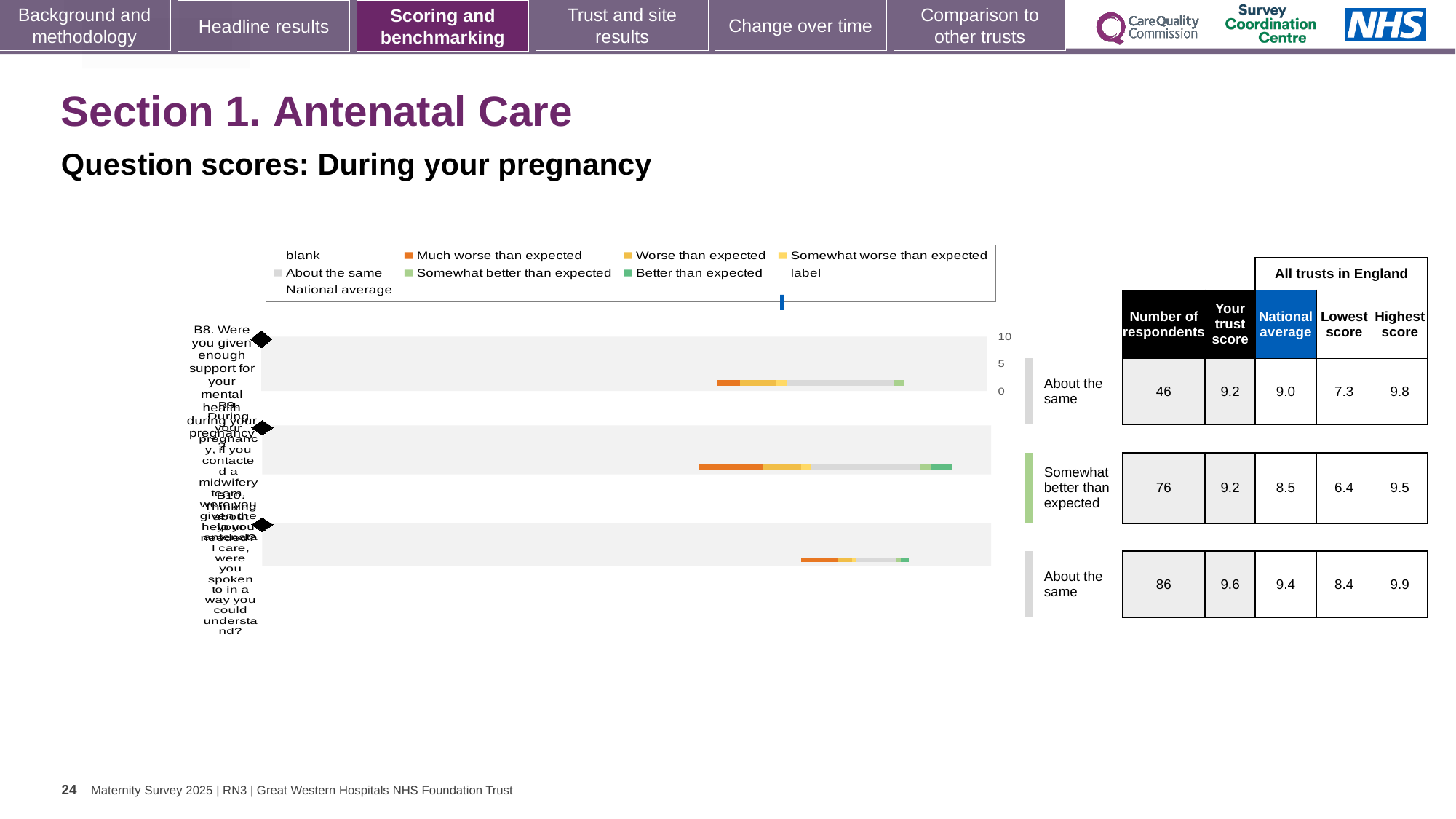
What is the 'Highest score' for the middle row in the table? 9.5 Which row has the highest 'Your trust score' in the table? The bottom row (9.6) For the middle row, what is the difference between 'Your trust score' and the 'National average'? 0.7 In the legend, what colour represents 'Much worse than expected'? Orange For the top row (B8), which is larger: 'Your trust score' or the 'National average'? Your trust score (9.2) How many question rows (bars) are plotted in the chart? 3 Which row has the lowest 'National average' in the table? The middle row (8.5) In the table next to the chart, what is 'Your trust score' for the bottom row? 9.6 In the table next to the chart, what is the number of respondents for the top row (B8, support for your mental health during pregnancy)? 46 What benchmark category label is shown beside the middle row of the chart? Somewhat better than expected What kind of chart is shown on the slide? Bar chart What is the 'Lowest score' for the bottom row in the table? 8.4